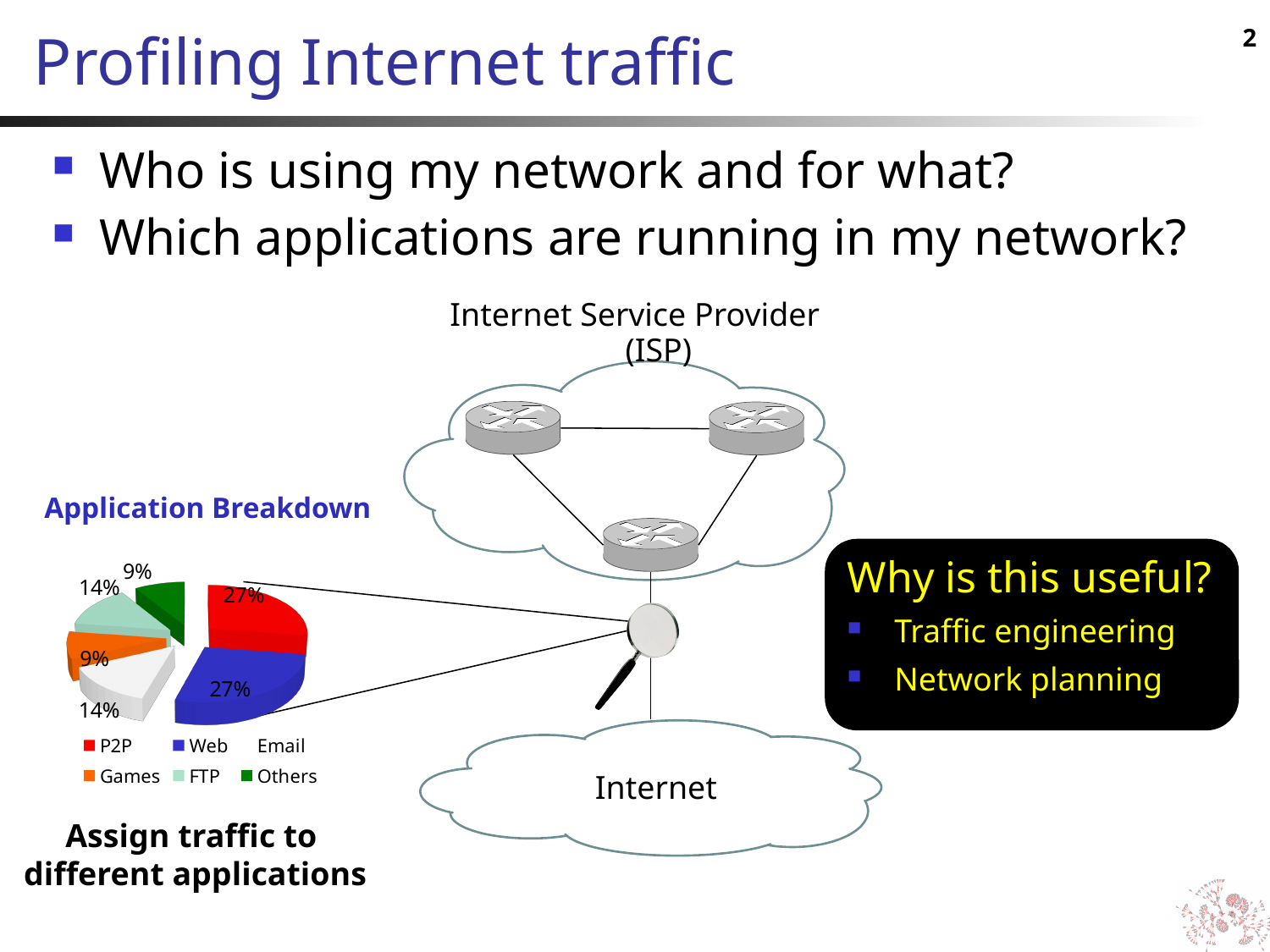
What share of traffic does P2P account for in the Application Breakdown pie chart? 27% What share of traffic does Web account for in the Application Breakdown pie chart? 27% What percentage is shown for Others in the Application Breakdown pie chart? 9% What percentage is shown for Games in the Application Breakdown pie chart? 9% In the Application Breakdown pie chart, which is larger, P2P or Email? P2P In the Application Breakdown pie chart, what is the difference between the Web share and the Games share? 18% How many categories does the Application Breakdown pie chart have? 6 What is the title of the pie chart on the slide? Application Breakdown What kind of chart is shown under the heading "Application Breakdown"? pie chart Which colour represents P2P in the Application Breakdown pie chart legend? red What percentage is shown for Email in the Application Breakdown pie chart? 14% What percentage is shown for FTP in the Application Breakdown pie chart? 14%